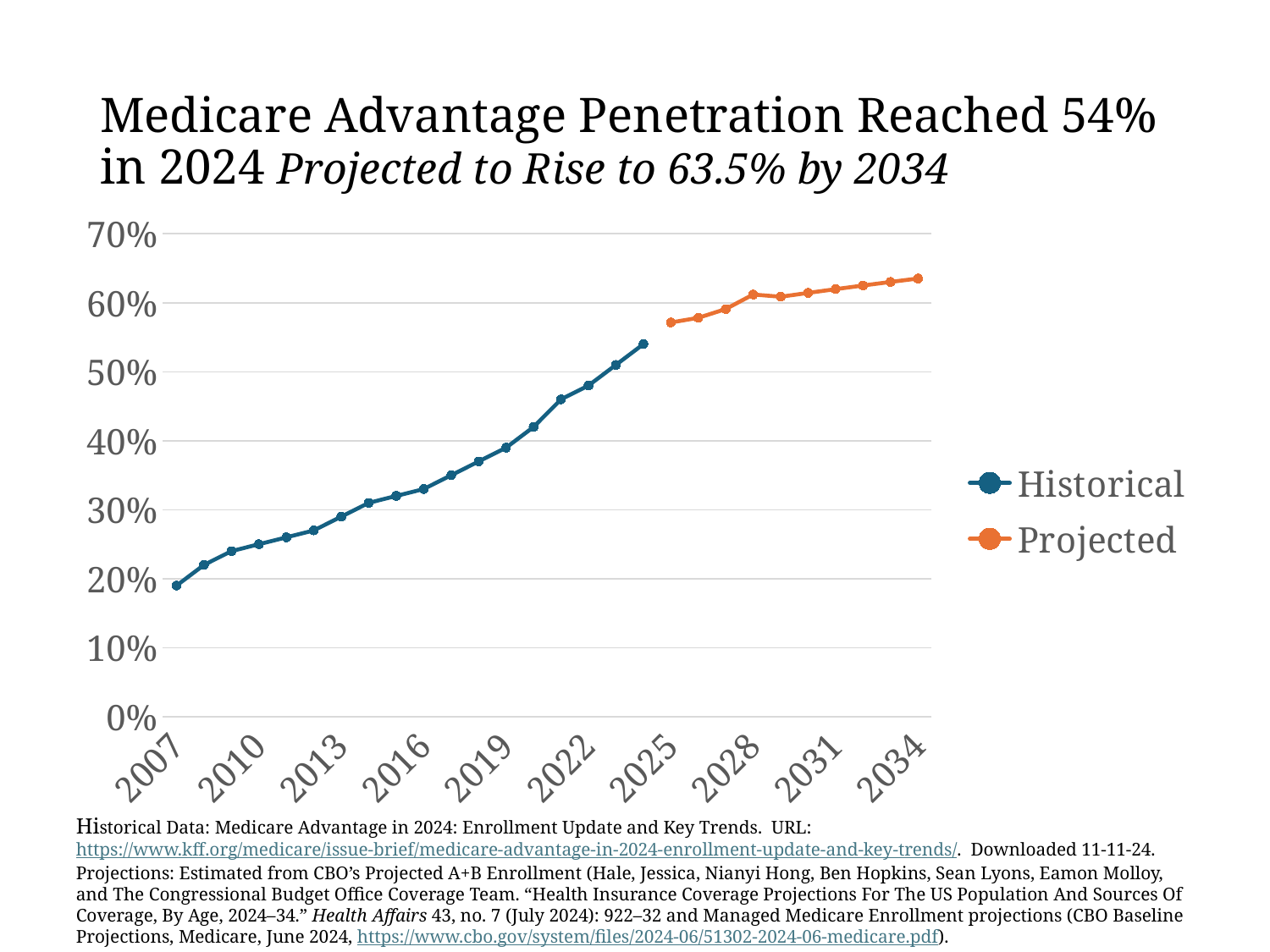
Is the value for 2034 greater or less than 60%? greater How many series does the legend list? 2 Is the value for 2016 greater or less than 30%? greater According to the slide, what was Medicare Advantage penetration in 2024? 54% What kind of chart is shown on the slide? Line chart Which year has the highest value on the chart? 2034 What are the two series named in the legend? Historical and Projected Which colour is used for the Projected series? Orange Do the values rise or fall from 2007 to 2034? Rise According to the slide, what is Medicare Advantage penetration projected to be by 2034? 63.5%